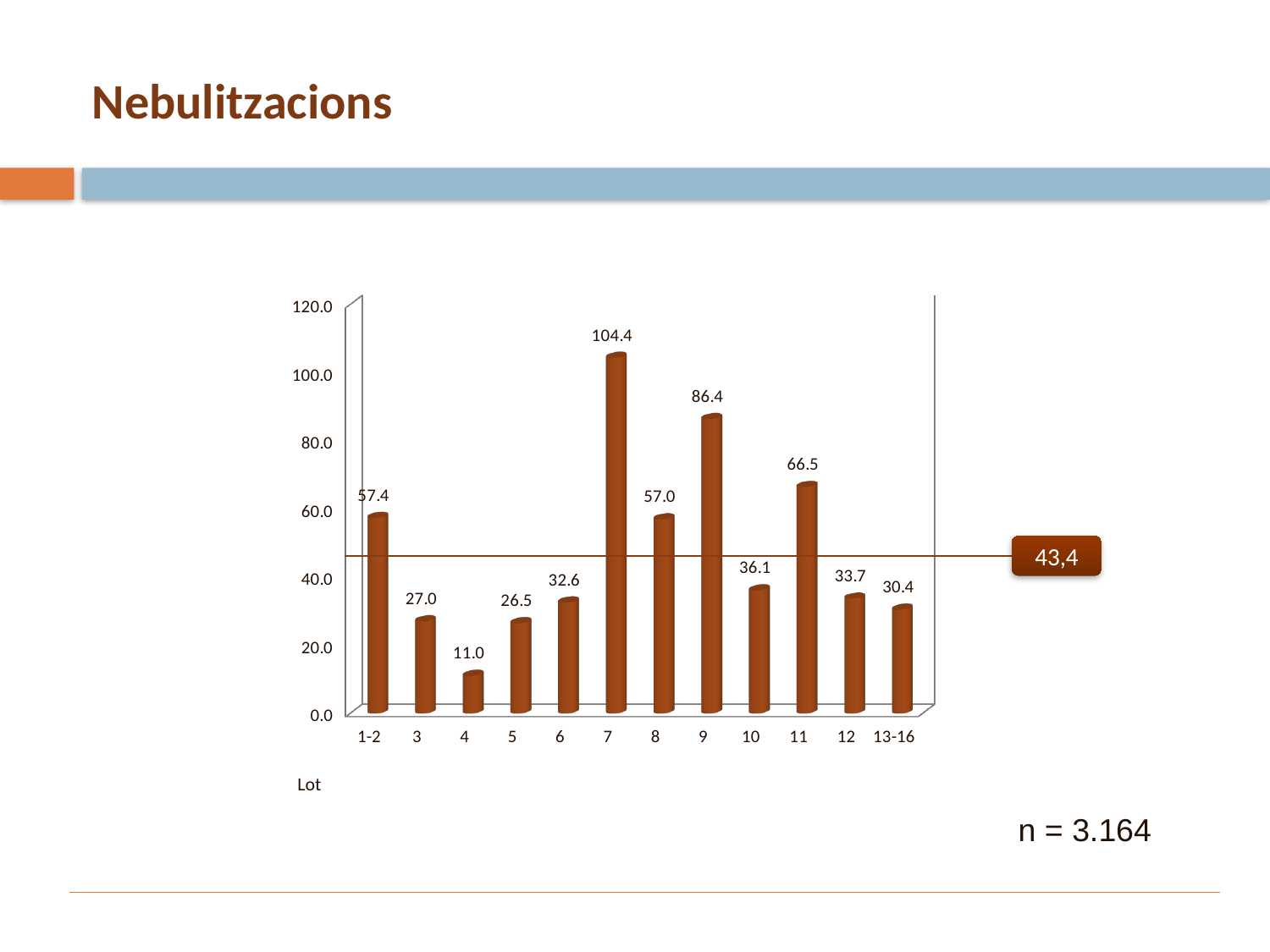
What is the title of the slide containing the chart? Nebulitzacions What is the value for Lot 4? 11.0 What value is shown in the label on the horizontal reference line? 43,4 What is the difference between the values for Lot 7 and Lot 9? 18.0 What is the value for Lot 13-16? 30.4 How many lot categories are shown on the x axis? 12 What is the value for Lot 7? 104.4 Which lot has the highest value? 7 What kind of chart is shown on the slide? bar chart Which lot has the lowest value? 4 Is the value for Lot 9 greater or less than 80.0? greater Which has a larger value, Lot 11 or Lot 8? Lot 11